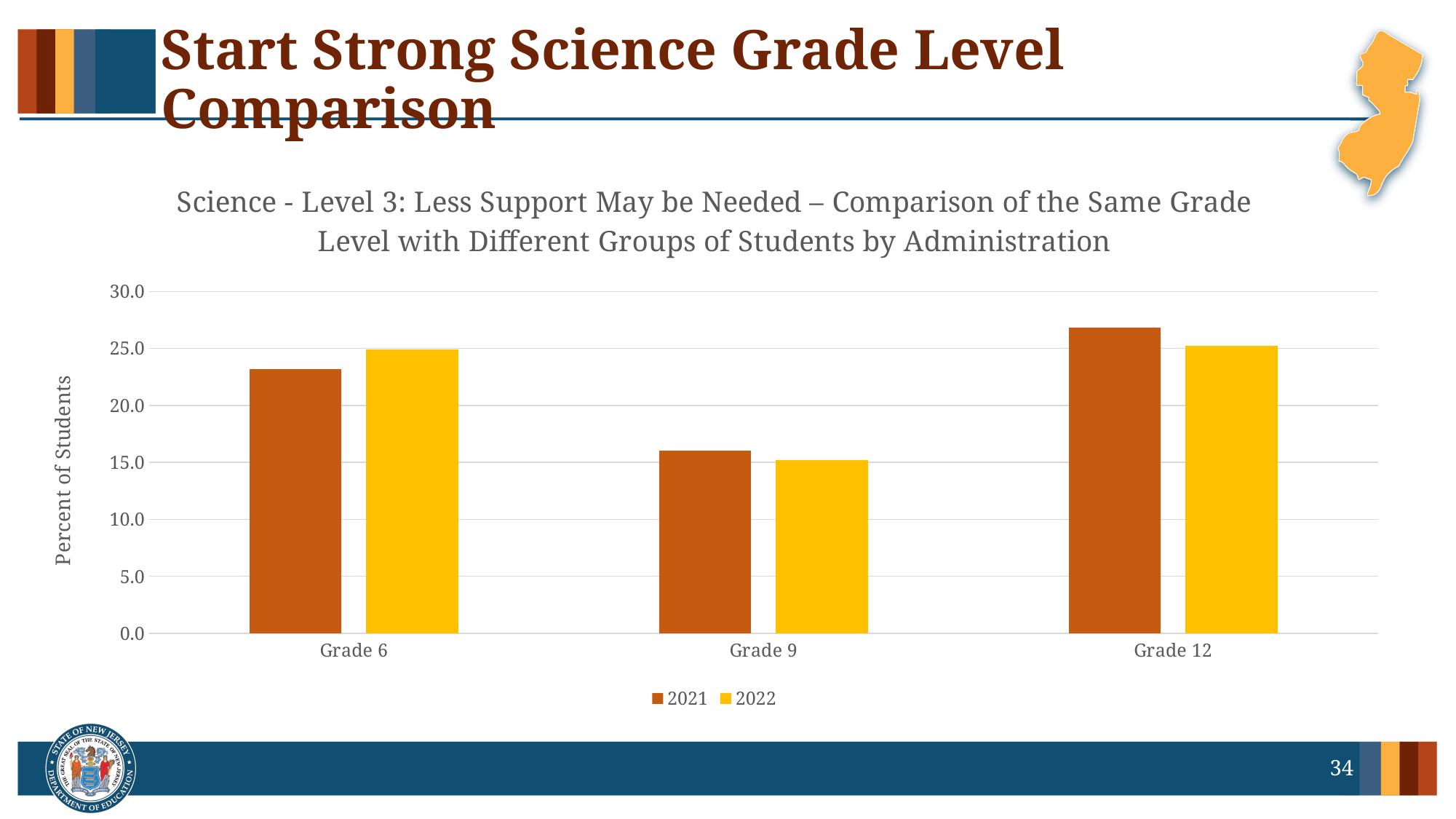
Which grade level has the highest 2021 value? Grade 12 How many series does the chart's legend list? 2 For Grade 12, which series has the larger value, 2021 or 2022? 2021 Which grade level has the lowest 2022 value? Grade 9 Is the 2021 value for Grade 12 greater or less than 25.0? greater What is the label on the chart's vertical axis? Percent of Students Is the 2021 value for Grade 6 greater or less than 20.0? greater Which colour represents the 2022 series in the chart? yellow Is the 2022 value for Grade 9 greater or less than 20.0? less For Grade 6, which series has the larger value, 2021 or 2022? 2022 What kind of chart is shown on the slide? bar chart How many grade levels are shown on the x axis of the chart? 3